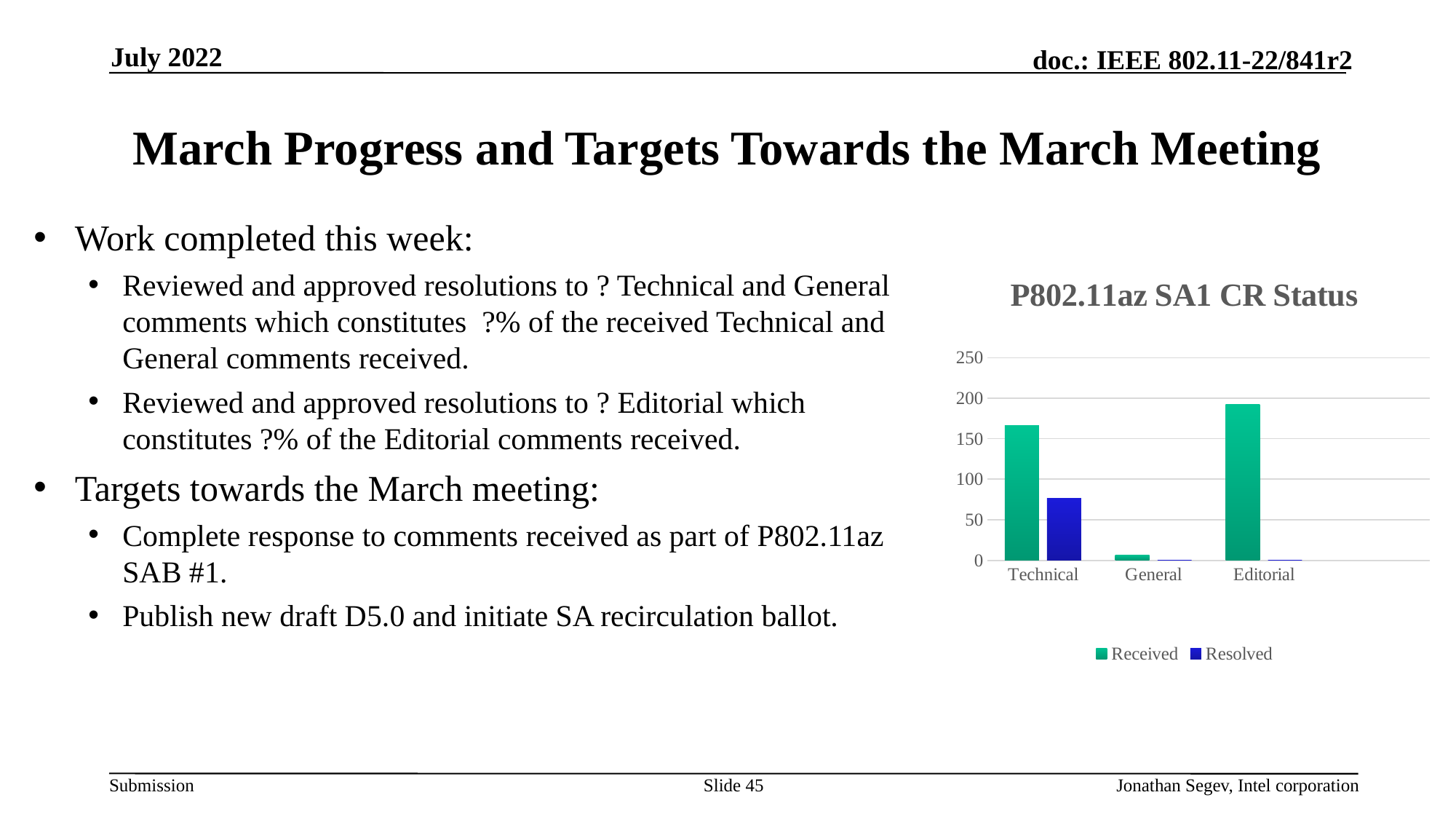
Which series is shown in blue in the chart? Resolved What is the title of the chart? P802.11az SA1 CR Status Is the Resolved value for Technical greater or less than 100? less For Technical, which is larger: the Received value or the Resolved value? Received How many series does the chart legend list? 2 What type of chart is shown on the slide? bar chart Is the Received value for General greater or less than 50? less Is the Received value for Editorial greater or less than 200? less Which category has the lowest Received value? General How many categories are shown on the x axis of the chart? 3 Which category has the highest Received value? Editorial